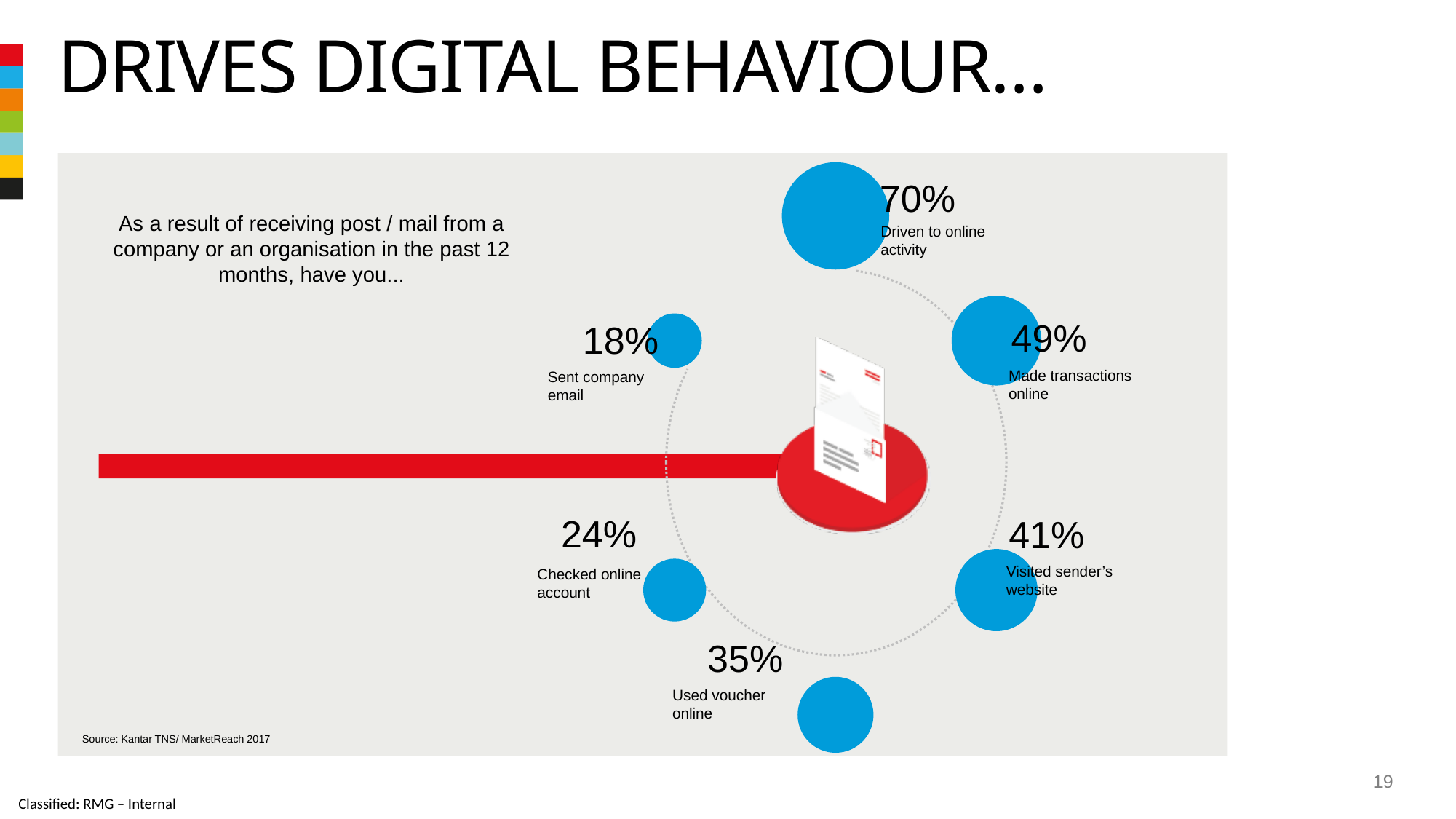
What percentage of respondents were driven to online activity as a result of receiving post / mail? 70% What percentage made transactions online? 49% Which behaviour has the lowest percentage? Sent company email What percentage sent a company email? 18% What source is cited for the data on the slide? Kantar TNS/ MarketReach 2017 Which behaviour has the highest percentage? Driven to online activity What percentage visited the sender's website? 41% What percentage checked an online account? 24% Which is larger: the percentage who visited the sender's website or the percentage who used a voucher online? Visited sender's website What is the difference in percentage points between 'Driven to online activity' and 'Made transactions online'? 21 How many behaviours are shown with percentages on the slide? 6 What percentage used a voucher online? 35%